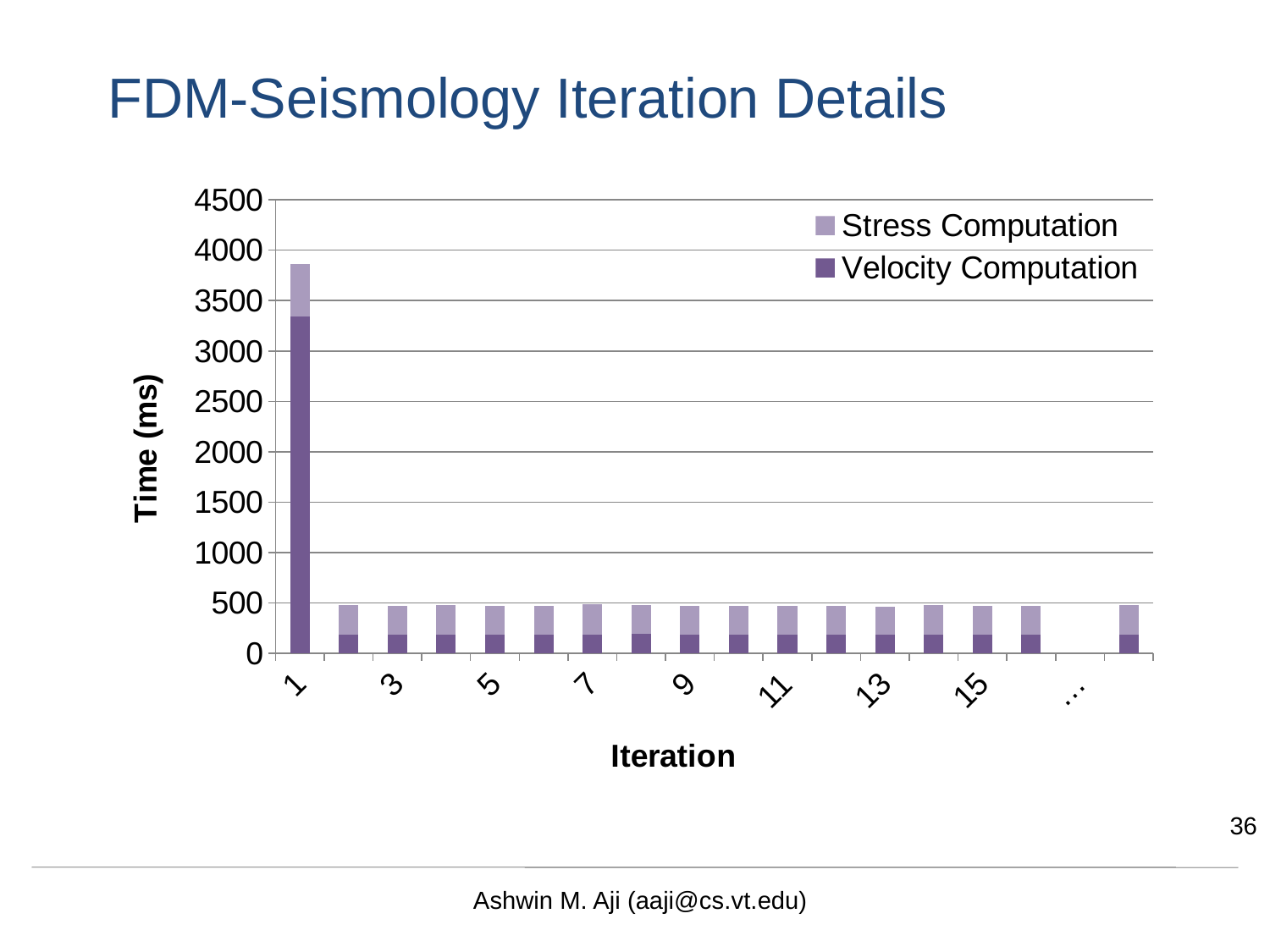
Which has the larger total time, iteration 1 or iteration 9? Iteration 1 In iteration 1, which series takes more time, Stress Computation or Velocity Computation? Velocity Computation Does the total time rise or fall from iteration 1 to iteration 2? Fall Which iteration has the highest total time? 1 How many series does the legend list? 2 Is the Velocity Computation time for iteration 1 greater or less than 3000? greater Is the total time for iteration 1 greater or less than 3500? greater What is the title of the y axis? Time (ms) What type of chart is shown on the slide? Stacked bar chart What are the two series named in the legend? Stress Computation and Velocity Computation Is the Velocity Computation time for iteration 5 greater or less than 500? less